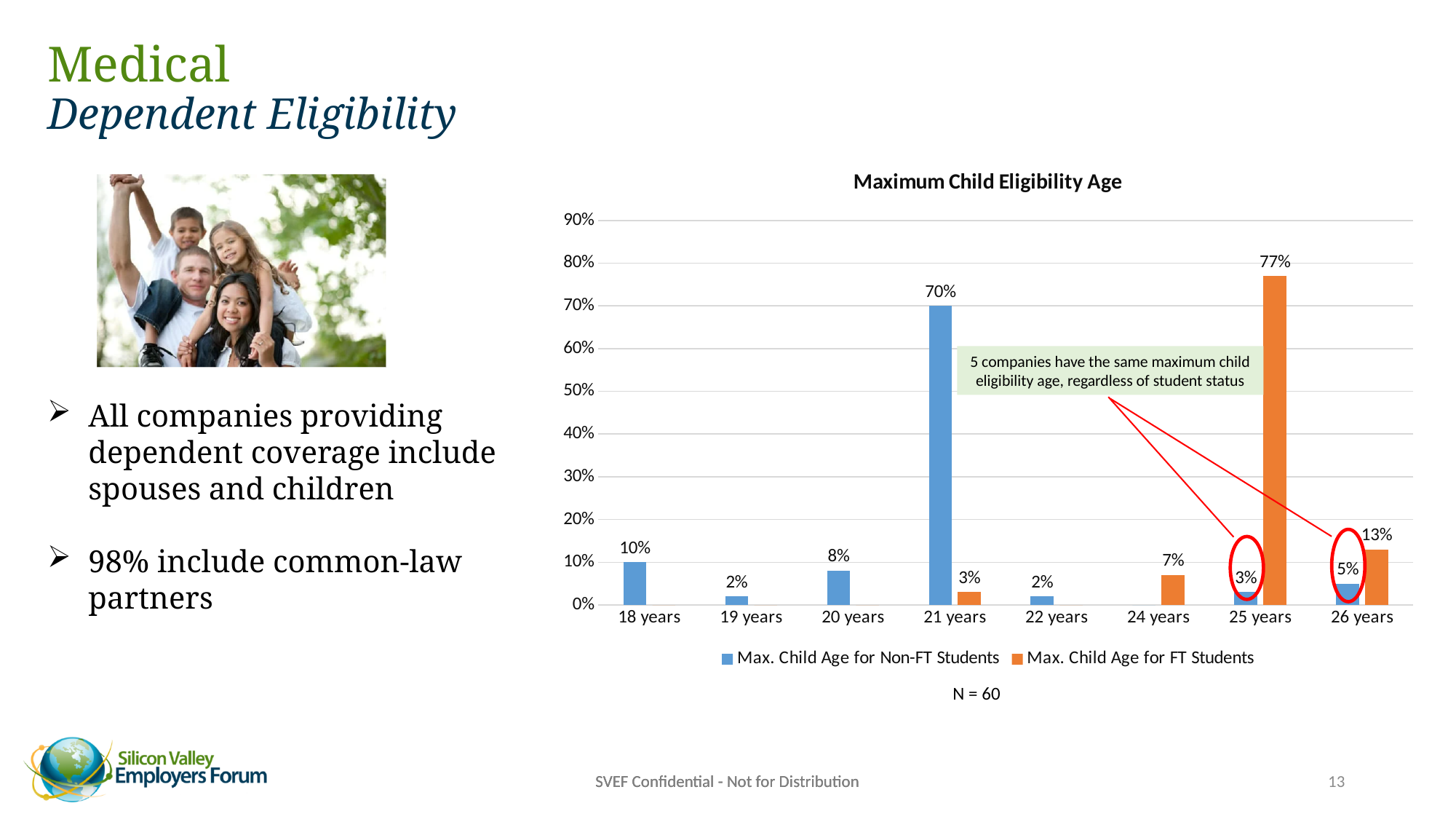
How many series does the legend list? 2 Which age category has the highest value for FT Students? 25 years What is the value for Non-FT Students at 21 years? 70% What is the value for FT Students at 25 years? 77% What is the difference between the FT Students value and the Non-FT Students value at 25 years? 74% What is the title of the chart? Maximum Child Eligibility Age What is the value for FT Students at 26 years? 13% What kind of chart is shown on the slide? Bar chart What is the value for Non-FT Students at 18 years? 10% Which age category has the highest value for Non-FT Students? 21 years At 26 years, which is larger: the value for Non-FT Students or for FT Students? FT Students How many age categories are shown on the x axis? 8